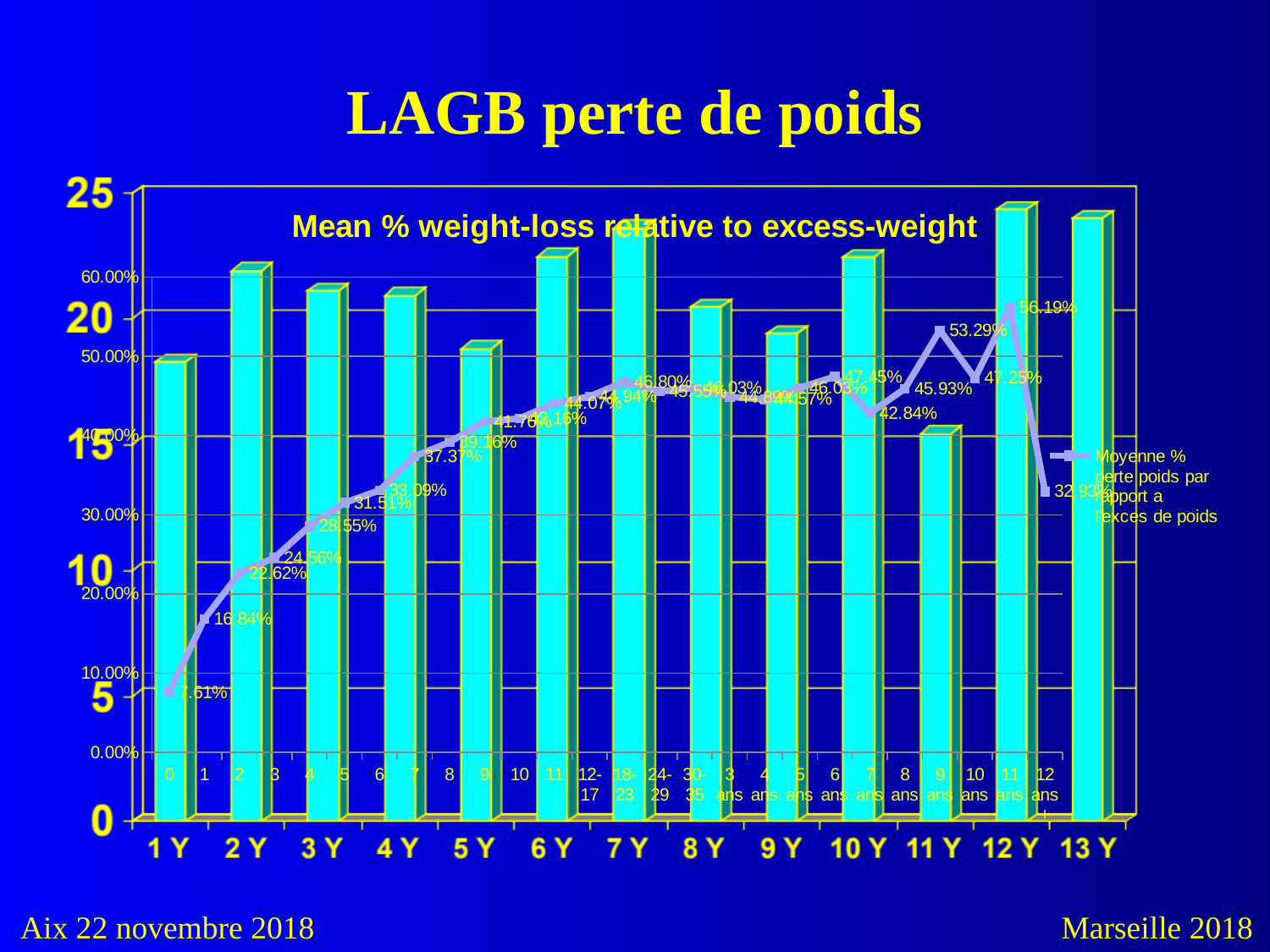
In the bar chart with categories 1 Y to 13 Y, which bar is taller, 2 Y or 11 Y? 2 Y In the line chart 'Mean % weight-loss relative to excess-weight', what is the legend entry? Moyenne % perte poids par rapport a l'exces de poids In the bar chart with categories 1 Y to 13 Y, is the value for 12 Y greater or less than 20? greater What type of chart is the chart titled 'Mean % weight-loss relative to excess-weight'? line chart In the line chart 'Mean % weight-loss relative to excess-weight', what is the value at category 0? 7.61% In the bar chart with categories 1 Y to 13 Y, is the value for 1 Y greater or less than 15? greater What type of chart is the cyan chart with categories 1 Y to 13 Y? bar chart In the bar chart with categories 1 Y to 13 Y, how many bars are there? 13 In the line chart 'Mean % weight-loss relative to excess-weight', what is the highest labelled value? 56.19% In the line chart 'Mean % weight-loss relative to excess-weight', what is the value at category 1? 16.84% In the bar chart with categories 1 Y to 13 Y, which category has the shortest bar? 11 Y In the bar chart with categories 1 Y to 13 Y, which category has the tallest bar? 12 Y